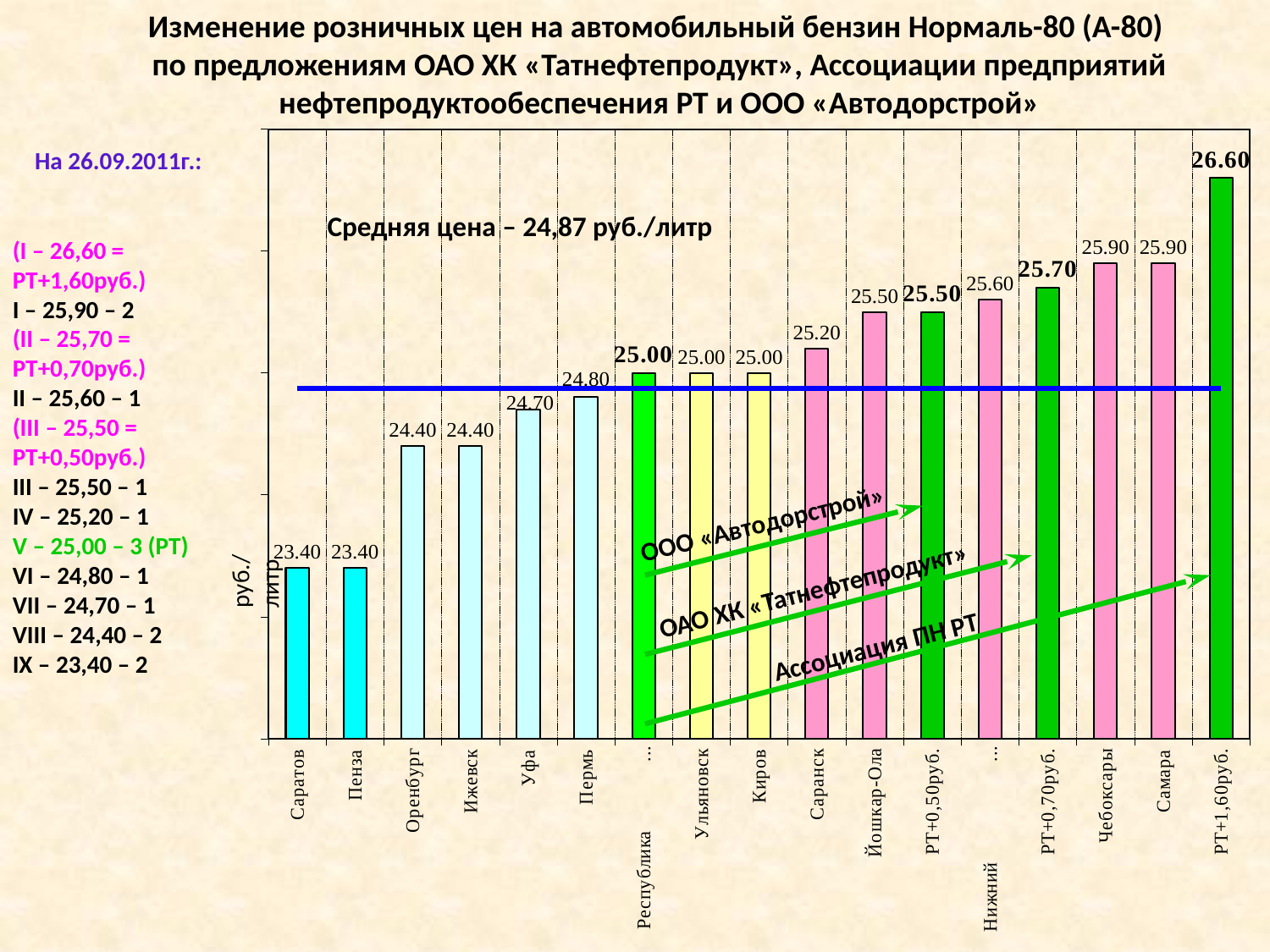
What is the value for Чебоксары? 25.90 What is the value for Саратов? 23.40 Which is larger, the value for Йошкар-Ола or the value for Саранск? Йошкар-Ола How many bars are plotted in the chart? 17 What average price (Средняя цена) is stated on the chart? 24,87 руб./литр Do the values generally rise or fall from left to right along the x axis? Rise What is the value for Уфа? 24.70 What is the value for РТ+0,70руб.? 25.70 What is the value for Саранск? 25.20 What is the difference between the values for РТ+1,60руб. and Пермь? 1.80 What kind of chart is shown on the slide? Bar chart Which category has the highest value? РТ+1,60руб.